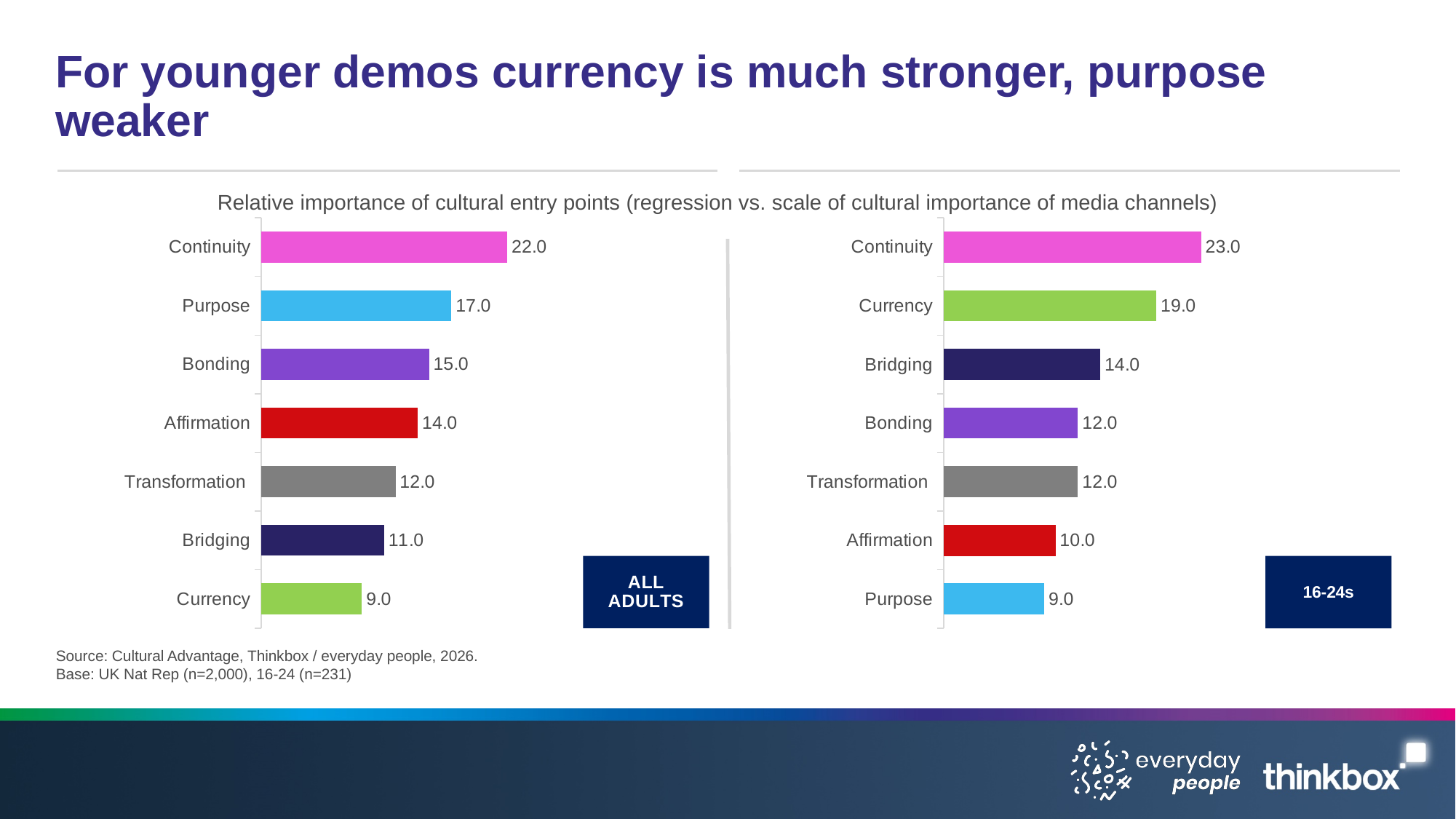
In the 16-24s chart, which is larger, Bridging or Bonding? Bridging In the ALL ADULTS chart, which is larger, Affirmation or Bridging? Affirmation In the 16-24s chart, what is the value for Currency? 19.0 In the ALL ADULTS chart, what is the difference between Continuity and Currency? 13.0 In the 16-24s chart, which category has the lowest value? Purpose How many categories are shown in the ALL ADULTS chart? 7 In the ALL ADULTS chart, what is the value for Transformation? 12.0 What is the title shown above the charts? Relative importance of cultural entry points (regression vs. scale of cultural importance of media channels) In the 16-24s chart, what is the difference between Currency and Affirmation? 9.0 What type of chart is used on this slide? Bar chart In the ALL ADULTS chart, which category has the highest value? Continuity In the ALL ADULTS chart, what is the value for Purpose? 17.0